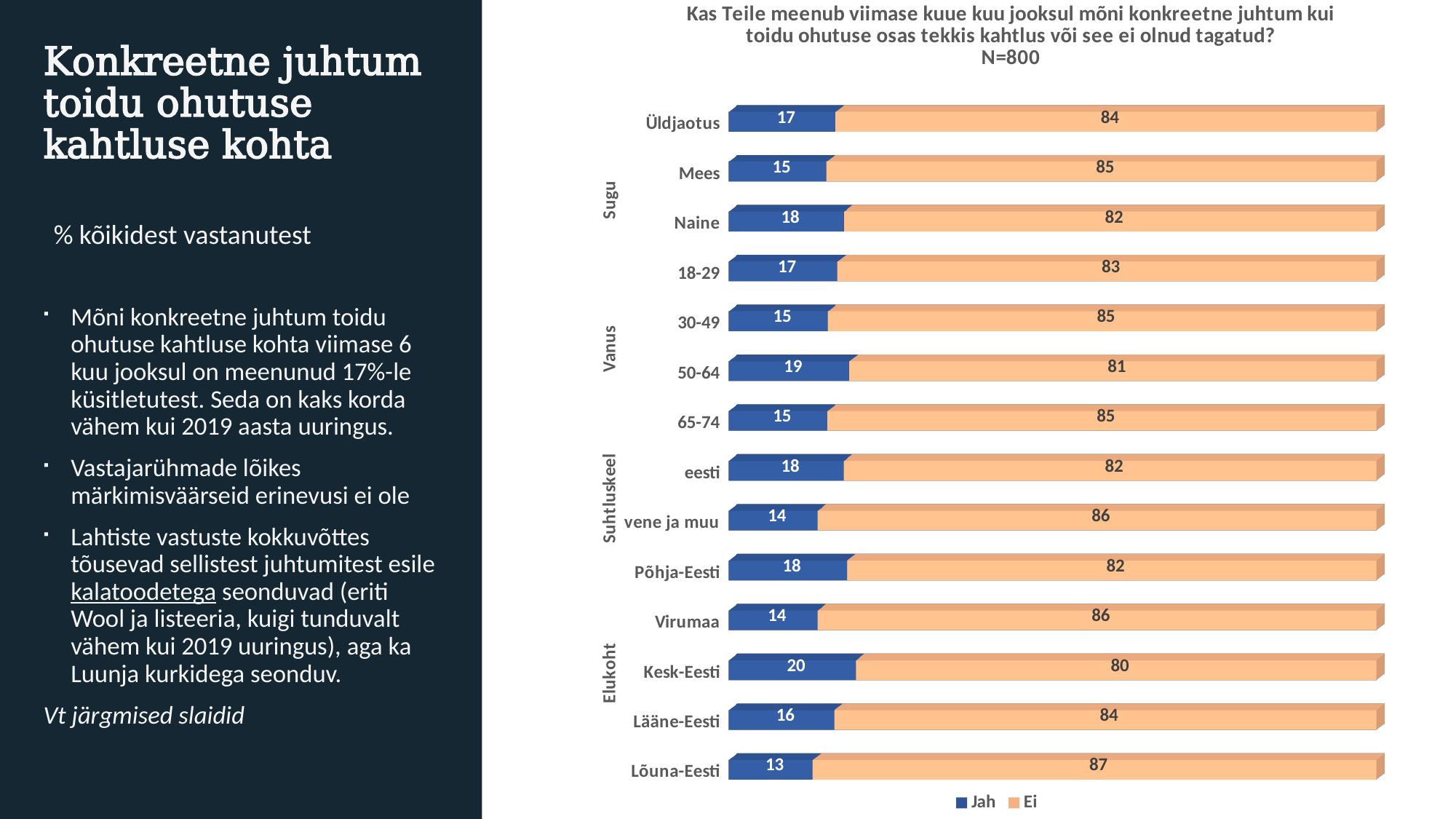
What is the total of the stacked bar for Kesk-Eesti? 100 What is the "Jah" value for 50-64? 19 What is the "Jah" value for Üldjaotus? 17 How many categories are shown on the chart? 14 Which has a larger "Ei" value, Virumaa or Kesk-Eesti? Virumaa What kind of chart is shown on the slide? Stacked bar chart How many series does the legend list? 2 What is the difference between the "Jah" values for Naine and Mees? 3 What is the "Ei" value for Lõuna-Eesti? 87 Which category has the highest "Jah" value? Kesk-Eesti What is the sample size (N) stated in the chart title? N=800 Which category has the lowest "Jah" value? Lõuna-Eesti